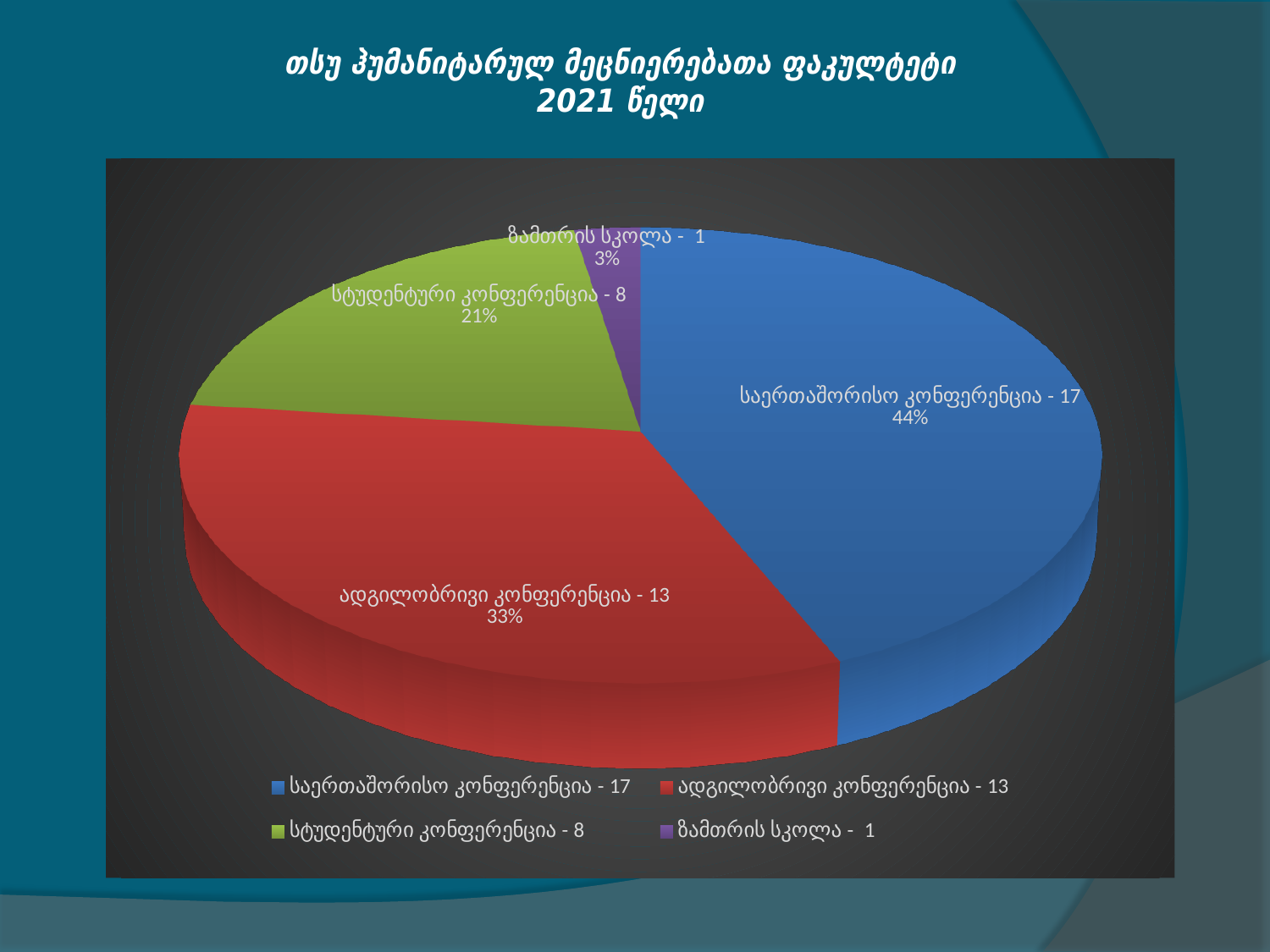
What percentage share does the slice "ადგილობრივი კონფერენცია - 13" have? 33% How many slices does the pie chart have? 4 What percentage share does the slice "სტუდენტური კონფერენცია - 8" have? 21% What colour is the slice for "სტუდენტური კონფერენცია - 8"? green What percentage share does the slice "საერთაშორისო კონფერენცია - 17" have? 44% Which slice of the pie chart is the smallest? ზამთრის სკოლა - 1 What kind of chart is shown on the slide? pie chart How many entries does the legend of the pie chart list? 4 Which slice of the pie chart is the largest? საერთაშორისო კონფერენცია - 17 What is the difference in percentage points between the shares of "საერთაშორისო კონფერენცია - 17" and "ადგილობრივი კონფერენცია - 13"? 11 Which has a larger share: "სტუდენტური კონფერენცია - 8" or "ადგილობრივი კონფერენცია - 13"? ადგილობრივი კონფერენცია - 13